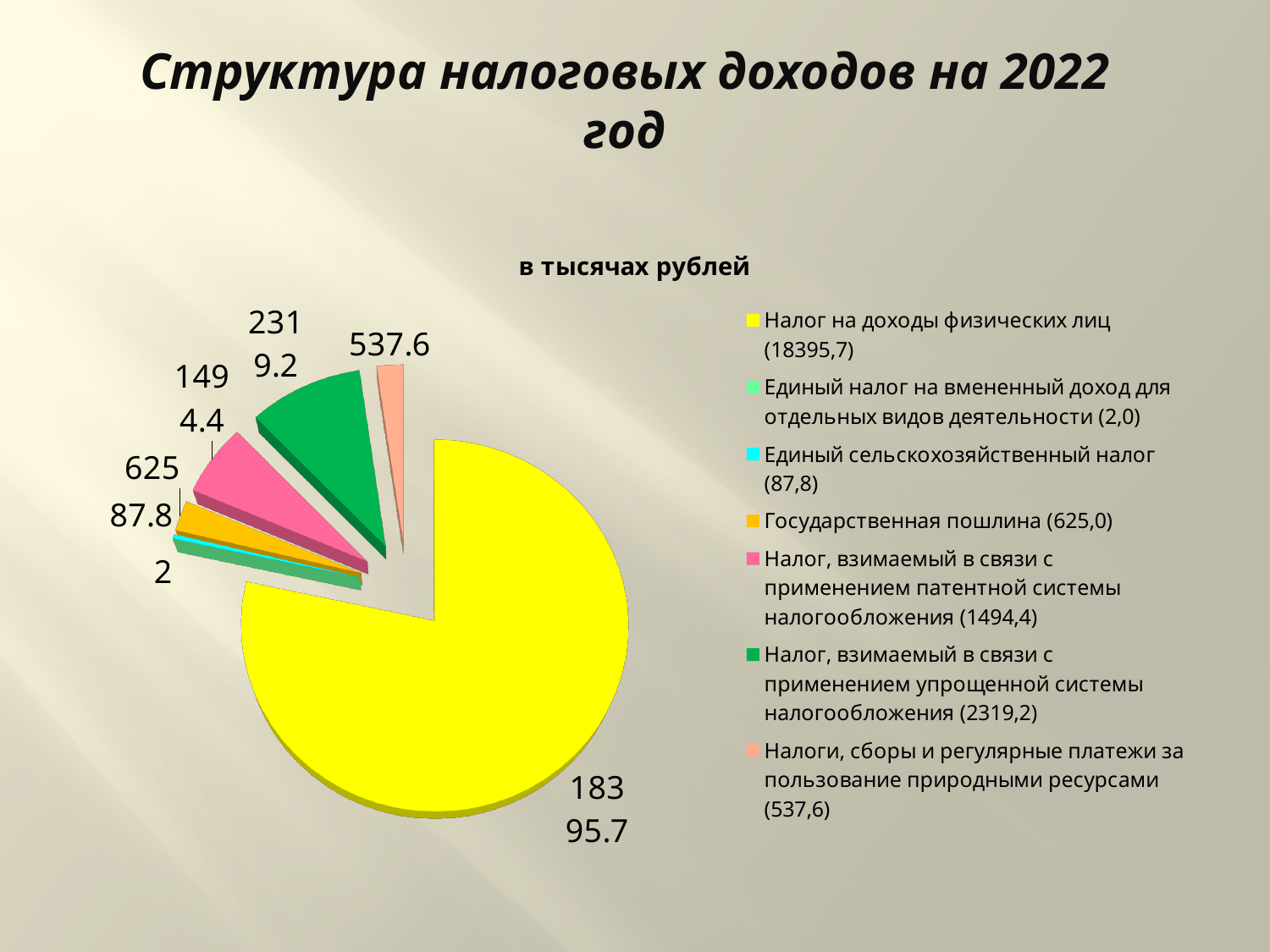
What is the difference between the values for Государственная пошлина (625) and Единый сельскохозяйственный налог (87.8)? 537.2 What kind of chart is shown on the slide? pie chart How many entries does the legend list? 7 What is the value shown for Налоги, сборы и регулярные платежи за пользование природными ресурсами? 537.6 Which category has the largest slice of the pie? Налог на доходы физических лиц Which category has the smallest slice of the pie? Единый налог на вмененный доход для отдельных видов деятельности How many categories does the pie chart have? 7 What value does the legend give for Налог, взимаемый в связи с применением упрощенной системы налогообложения? 2319,2 What is the value shown for Единый сельскохозяйственный налог? 87.8 What is the value shown for Государственная пошлина? 625 What unit is stated above the chart? в тысячах рублей Which is larger: Государственная пошлина or Единый сельскохозяйственный налог? Государственная пошлина